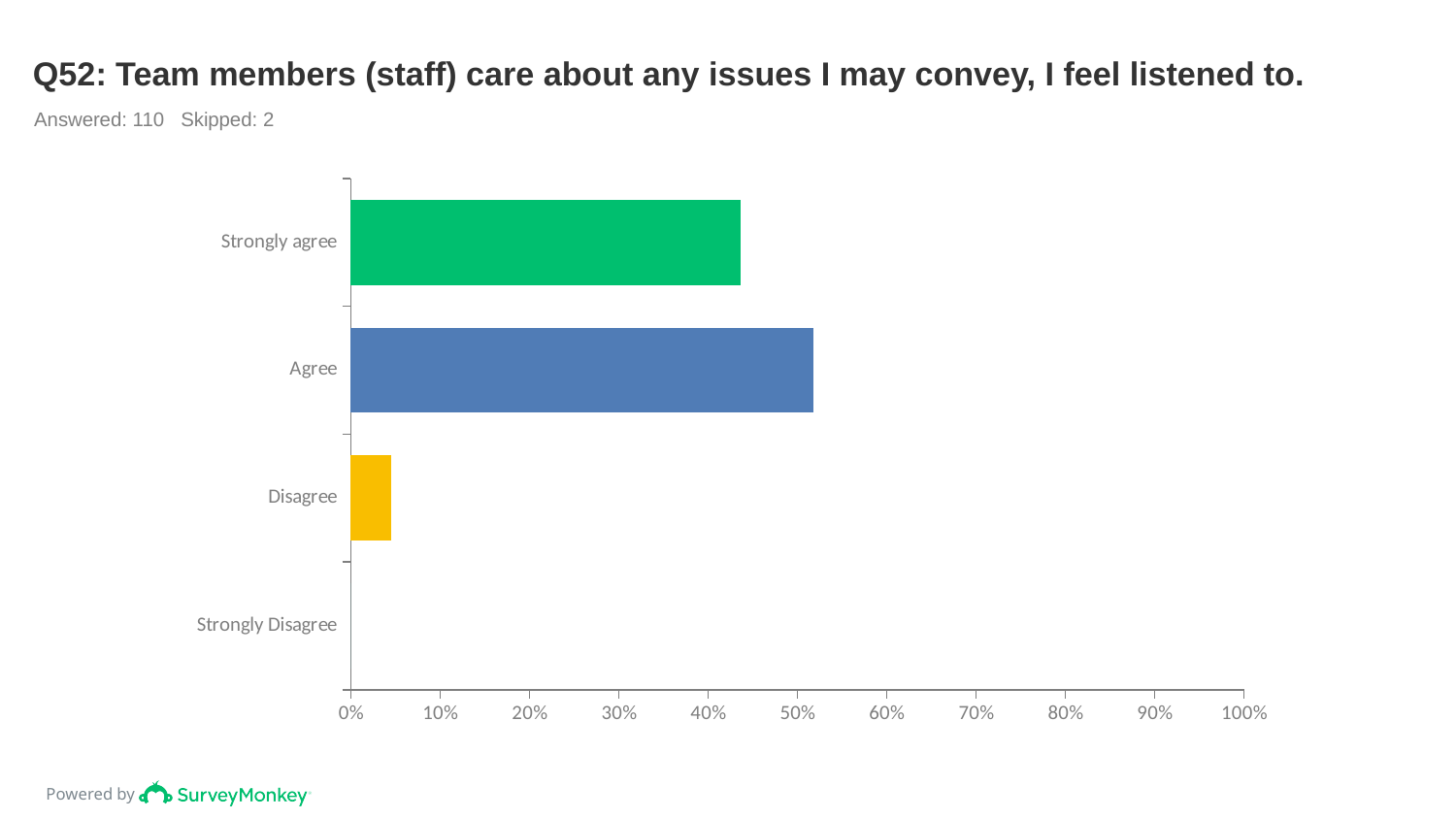
Is the value for Agree greater or less than 60%? less What kind of chart is shown on the slide? bar chart Which response category has the highest value? Agree Which is larger, the value for Strongly agree or the value for Agree? Agree What colour is the bar for Agree? blue Which is larger, the value for Disagree or the value for Strongly agree? Strongly agree How many response categories are shown on the chart? 4 Is the value for Disagree greater or less than 10%? less Is the value for Strongly agree greater or less than 50%? less How many respondents answered this question according to the slide? 110 Which response category has the lowest value? Strongly Disagree